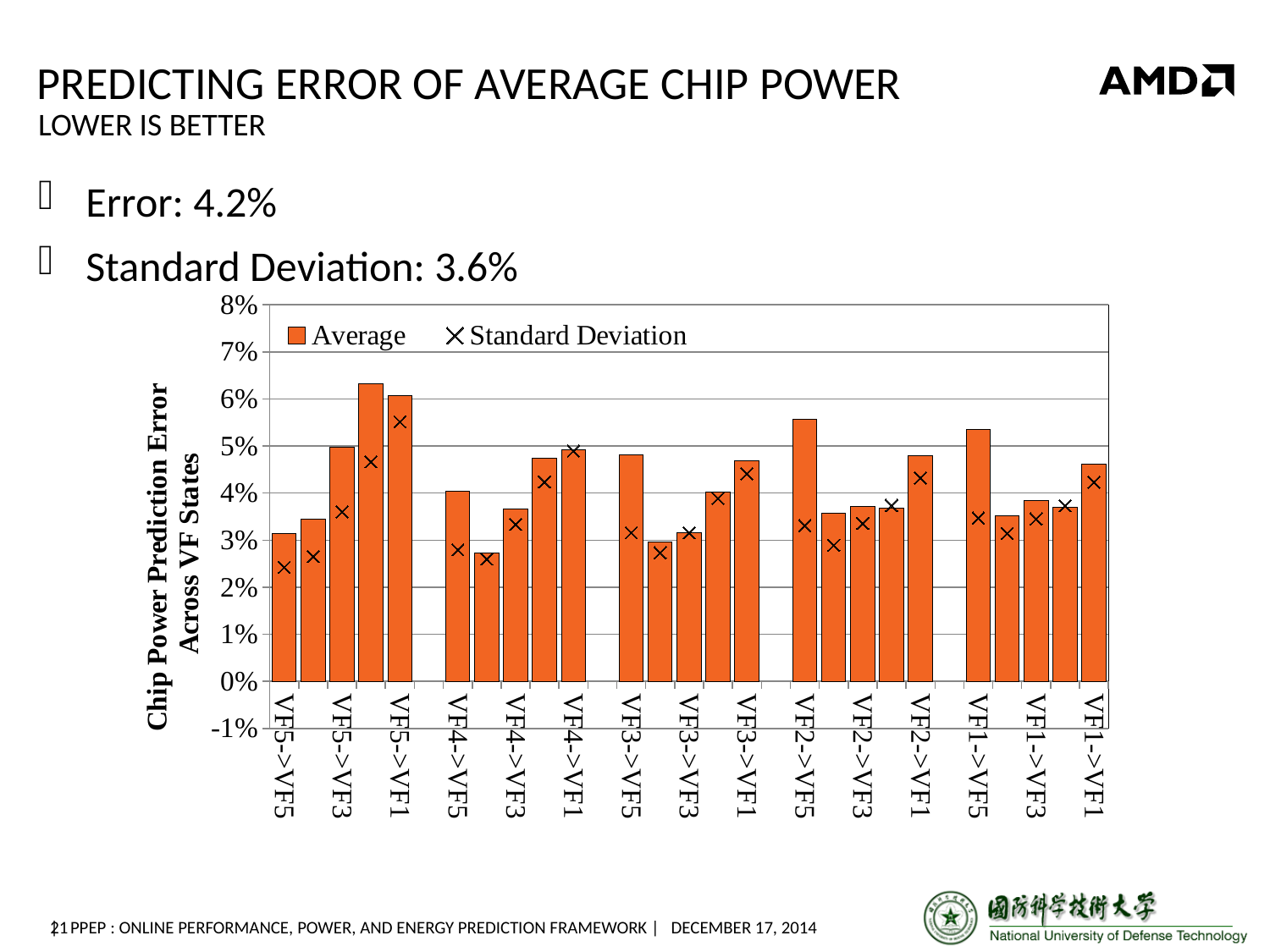
Is the Standard Deviation value for VF5->VF5 greater or less than 3%? less What are the two series named in the chart legend? Average and Standard Deviation Is the Average value for VF2->VF5 greater or less than 5%? greater What kind of chart is shown on the slide? bar chart Is the Standard Deviation value for VF5->VF1 greater or less than 5%? greater Which has the larger Average value, VF2->VF5 or VF2->VF3? VF2->VF5 What is the title of the chart's vertical axis? Chip Power Prediction Error Across VF States Which has the larger Average value, VF5->VF1 or VF1->VF1? VF5->VF1 How many series does the chart legend list? 2